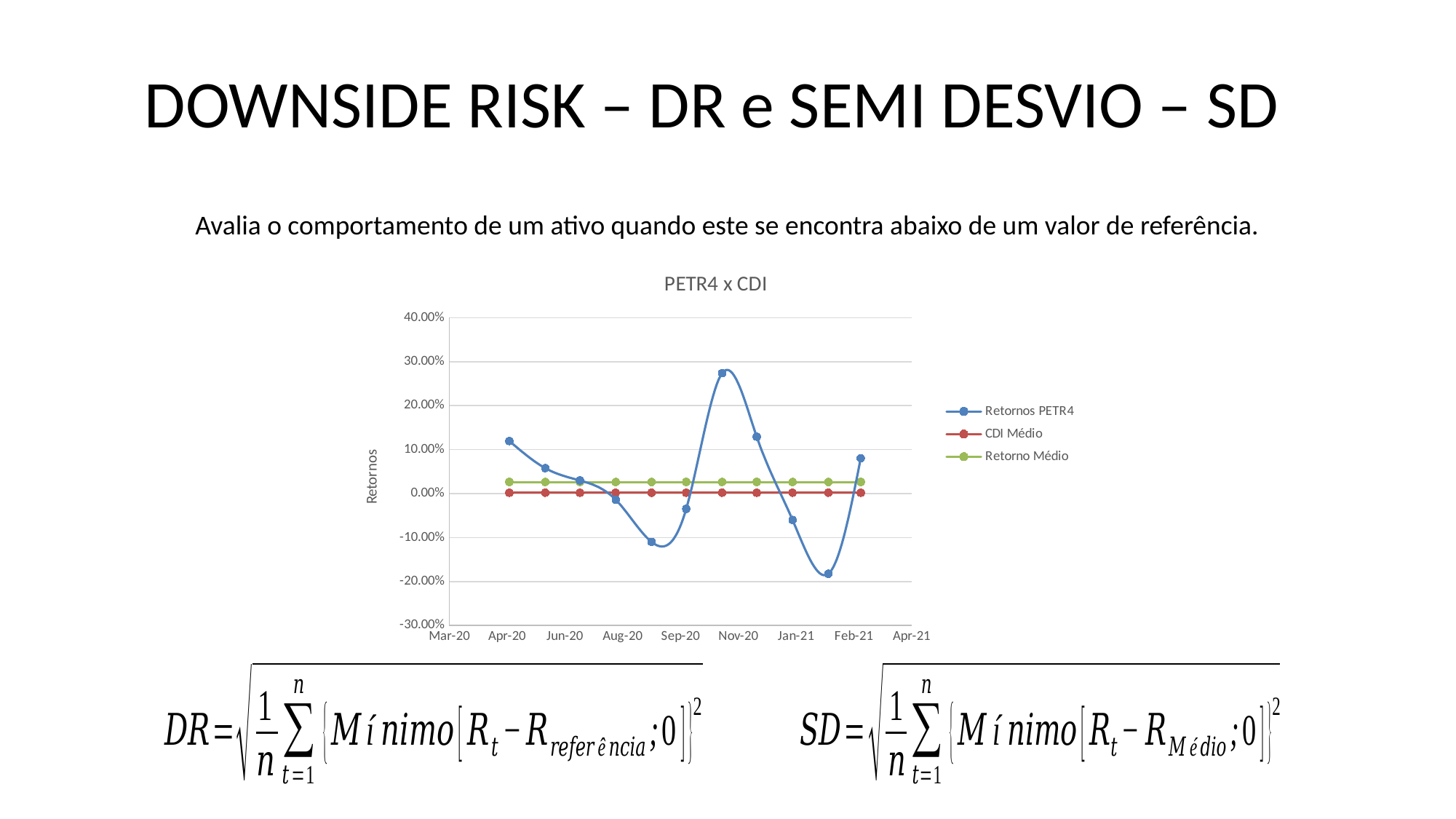
Which series is plotted higher on the chart, CDI Médio or Retorno Médio? Retorno Médio How many series does the chart legend list? 3 Does the Retornos PETR4 series rise or fall from Apr-20 to Jun-20? fall Is the highest value of the Retornos PETR4 series greater or less than 20.00%? greater Is the lowest value of the Retornos PETR4 series greater or less than -10.00%? less Is the value of Retornos PETR4 at Aug-20 greater or less than 0.00%? less What kind of chart is shown on the slide? line chart What is the label of the vertical axis of the chart? Retornos What is the title of the chart? PETR4 x CDI